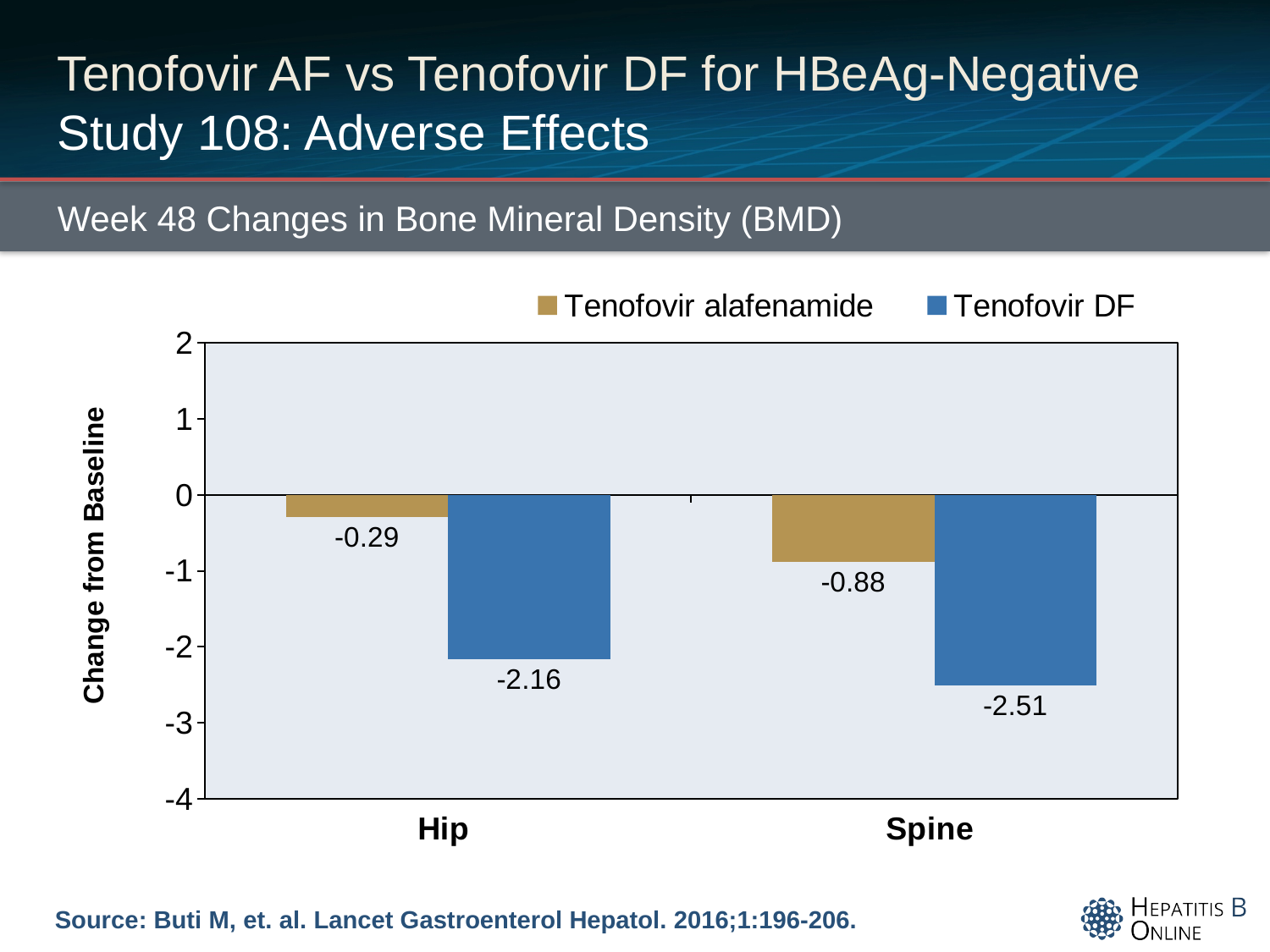
What is the change from baseline in spine BMD for Tenofovir alafenamide? -0.88 What kind of chart is shown on the slide? Bar chart How many series does the legend list? 2 What is the change from baseline in hip BMD for Tenofovir DF? -2.16 How many categories are shown on the x axis? 2 Which category and series shows the smallest decrease from baseline? Hip, Tenofovir alafenamide What is the difference between the Tenofovir DF and Tenofovir alafenamide changes for Spine? 1.63 Which series shows a larger decrease in spine BMD, Tenofovir alafenamide or Tenofovir DF? Tenofovir DF What is the change from baseline in hip BMD for Tenofovir alafenamide? -0.29 What is the change from baseline in spine BMD for Tenofovir DF? -2.51 What is the difference between the Tenofovir DF and Tenofovir alafenamide changes for Hip? 1.87 Which category and series shows the largest decrease from baseline? Spine, Tenofovir DF